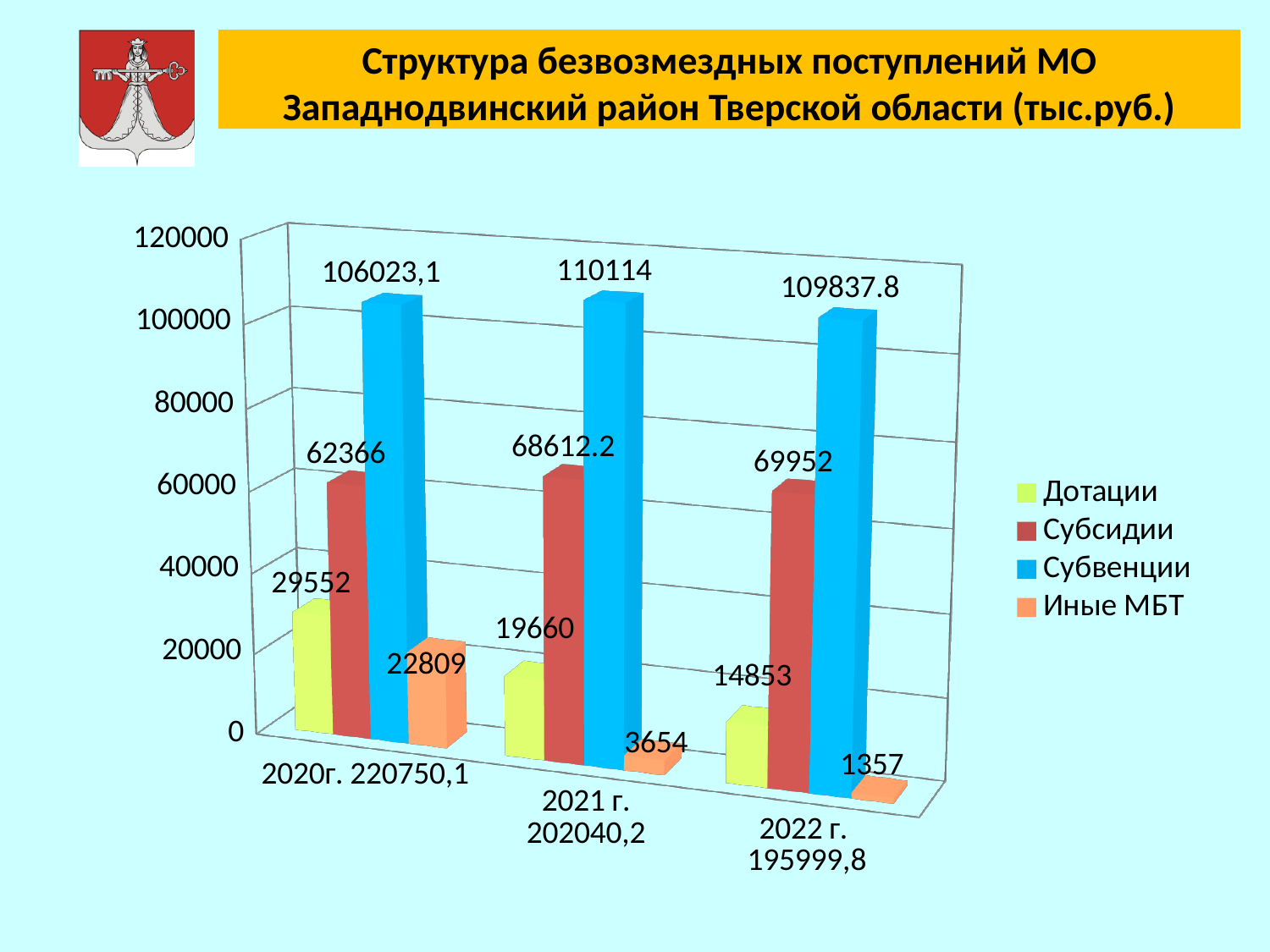
What kind of chart is shown on the slide? Bar chart Which is larger: Субсидии in 2022 г. or Субсидии in 2020г.? Субсидии in 2022 г. What is the difference between Дотации in 2020г. and Дотации in 2022 г.? 14699 What is the value of Иные МБТ for 2022 г.? 1357 In which year is the value of Субвенции the highest? 2021 г. Do the values of Дотации rise or fall from 2020г. to 2022 г.? Fall What is the value of Субсидии for 2021 г.? 68612.2 In which year is the value of Иные МБТ the lowest? 2022 г. What is the value of Дотации for 2020г.? 29552 What is the value of Субвенции for 2020г.? 106023,1 How many year categories are shown on the x axis? 3 How many series does the legend list? 4